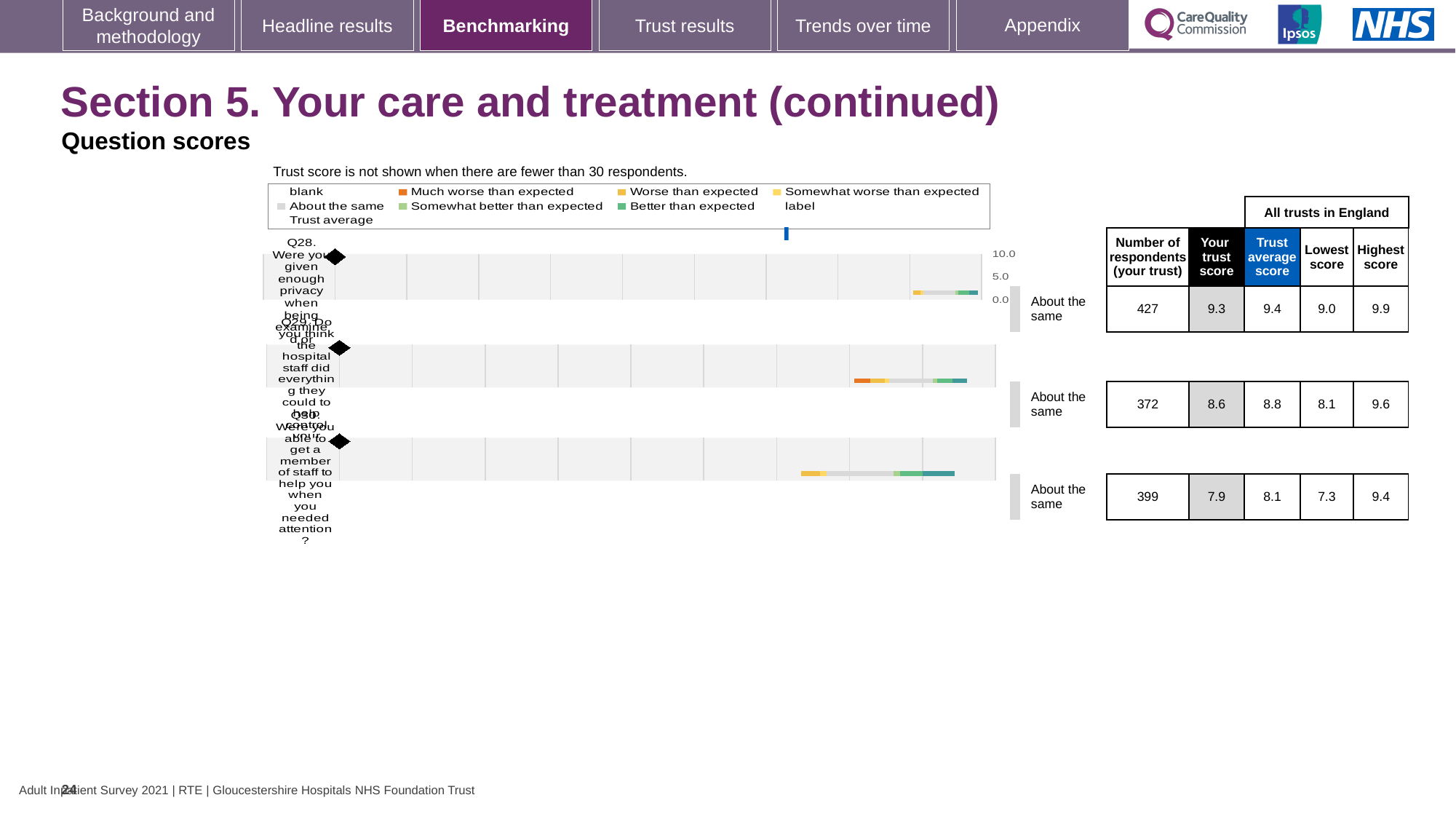
For Q28, is your trust score higher or lower than the trust average score? lower What is the lowest score among all trusts in England for Q30? 7.3 Which of the three questions shown has the lowest number of respondents? Q29 What type of chart is used to show the question scores? bar chart How many questions are plotted on this slide? 3 What is the difference between the highest score and the lowest score for Q29? 1.5 What is your trust score for Q29 (Do you think the hospital staff did everything they could to help control your pain)? 8.6 What benchmark category is shown next to each of the three questions? About the same What is the trust average score for Q30 (Were you able to get a member of staff to help you when you needed attention)? 8.1 What is the highest score among all trusts in England for Q28? 9.9 How many respondents from your trust answered Q28 (Were you given enough privacy when being examined or treated)? 427 Which of the three questions shown has the highest 'Your trust score'? Q28